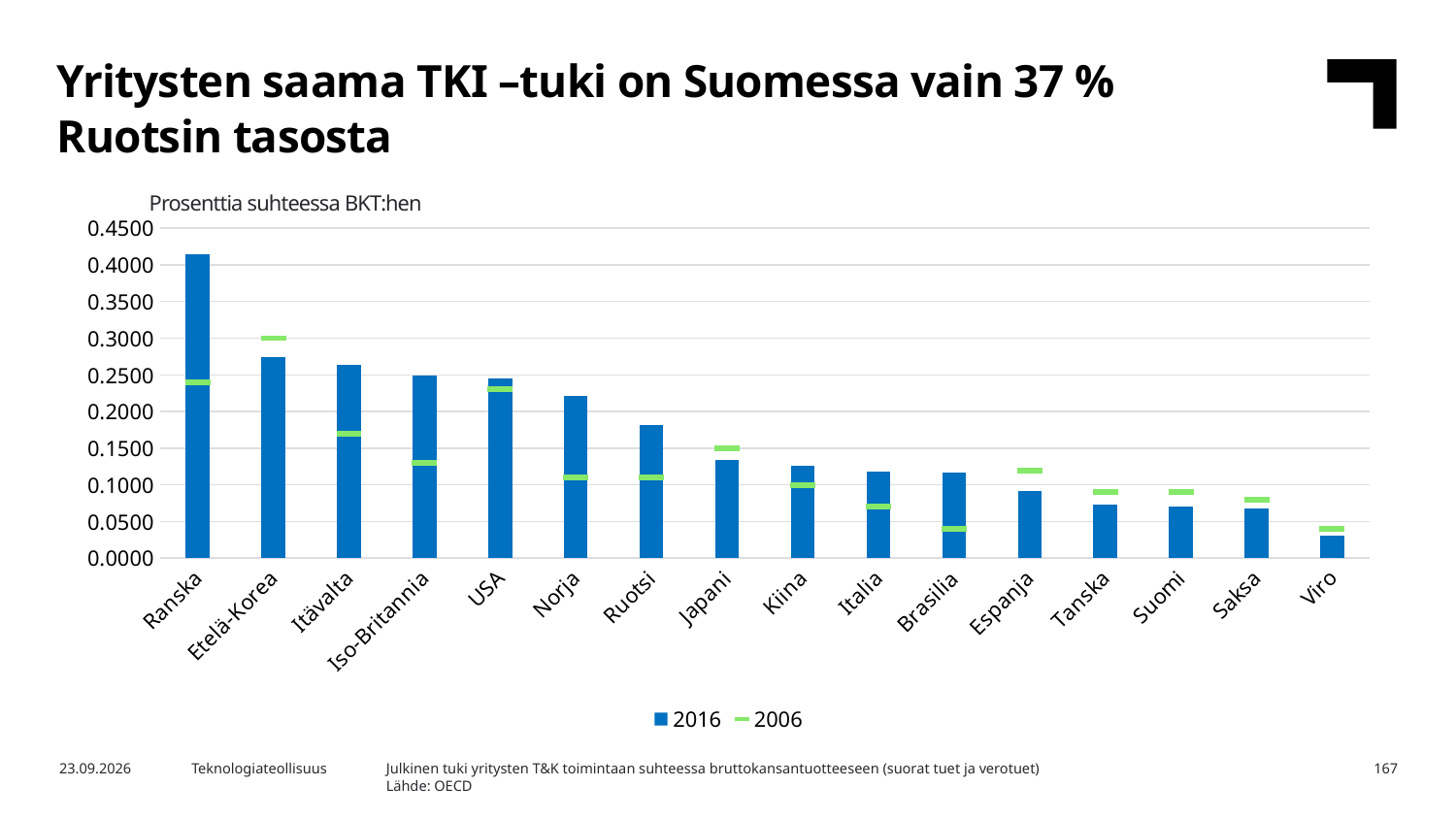
What kind of chart is shown on the slide? Bar chart Do the 2016 values rise or fall moving from left to right along the x axis? fall Which country has the highest 2016 value? Ranska How many countries are shown on the x axis? 16 How many series does the legend list? 2 What are the two series named in the legend? 2016 and 2006 Is the 2016 value for Ranska greater or less than 0.4000? greater Which country has the lowest 2016 value? Viro Is the 2016 value for Viro greater or less than 0.0500? less Which has the larger 2016 value, Suomi or Ruotsi? Ruotsi Is the 2016 value for Suomi greater or less than 0.1000? less